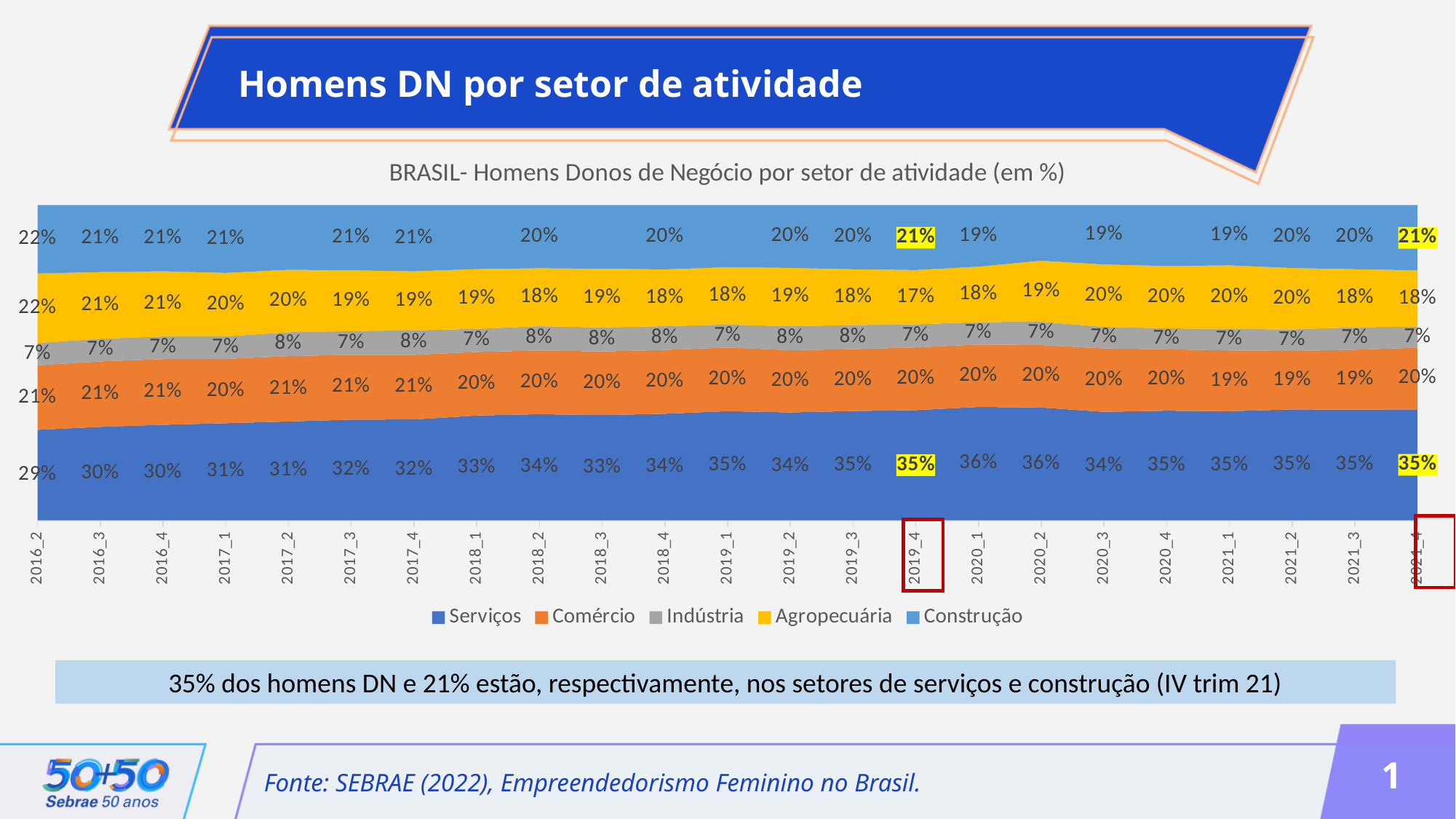
How many series does the legend list? 5 What is the difference between the Serviços value in 2021_4 and in 2016_2? 6% What is the value for Agropecuária in 2016_2? 22% What is the value for Serviços in 2021_4? 35% What is the value for Comércio in 2021_1? 19% In which period does Agropecuária reach its lowest value? 2019_4 What is the value for Indústria in 2017_2? 8% Does the Serviços series generally rise or fall from 2016_2 to 2021_4? rise Which is larger in 2020_2: Agropecuária or Comércio? Comércio What is the value for Construção in 2019_4? 21% What kind of chart is shown on the slide? stacked area chart How many time periods are shown on the x axis? 23